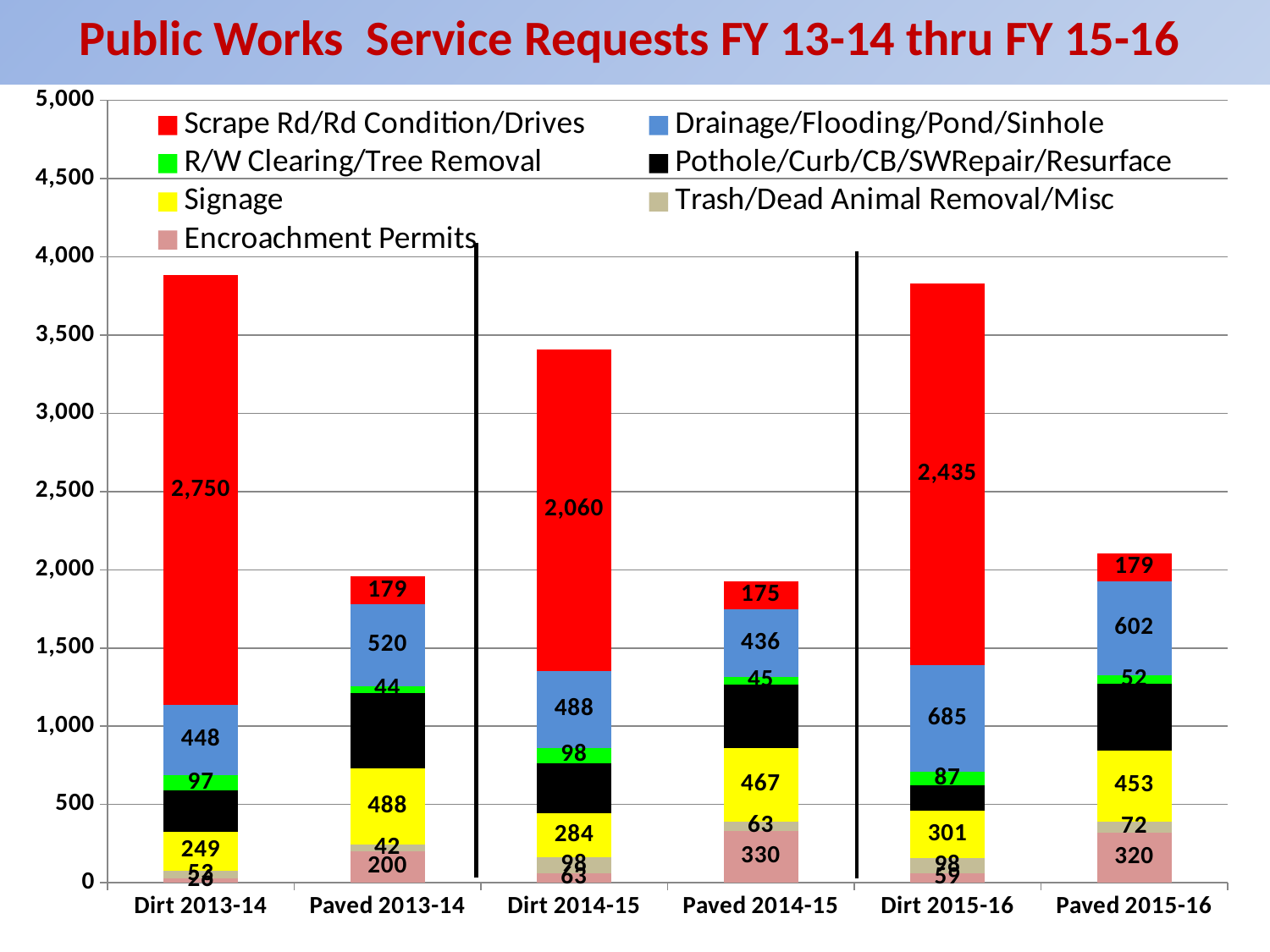
Which has the larger Drainage/Flooding/Pond/Sinhole value, Paved 2013-14 or Paved 2015-16? Paved 2015-16 What is the Encroachment Permits value for Paved 2015-16? 320 What kind of chart is shown on the slide? Stacked bar chart Which category has the highest Scrape Rd/Rd Condition/Drives value? Dirt 2013-14 What is the Trash/Dead Animal Removal/Misc value for Paved 2015-16? 72 How many categories are shown along the x axis? 6 What is the Signage value for Paved 2014-15? 467 What is the difference between the Scrape Rd/Rd Condition/Drives values for Dirt 2013-14 and Dirt 2014-15? 690 How many series does the legend list? 7 What is the Drainage/Flooding/Pond/Sinhole value for Dirt 2015-16? 685 Is the total height of the Dirt 2013-14 bar greater or less than 3,500? greater What is the Scrape Rd/Rd Condition/Drives value for Dirt 2013-14? 2,750